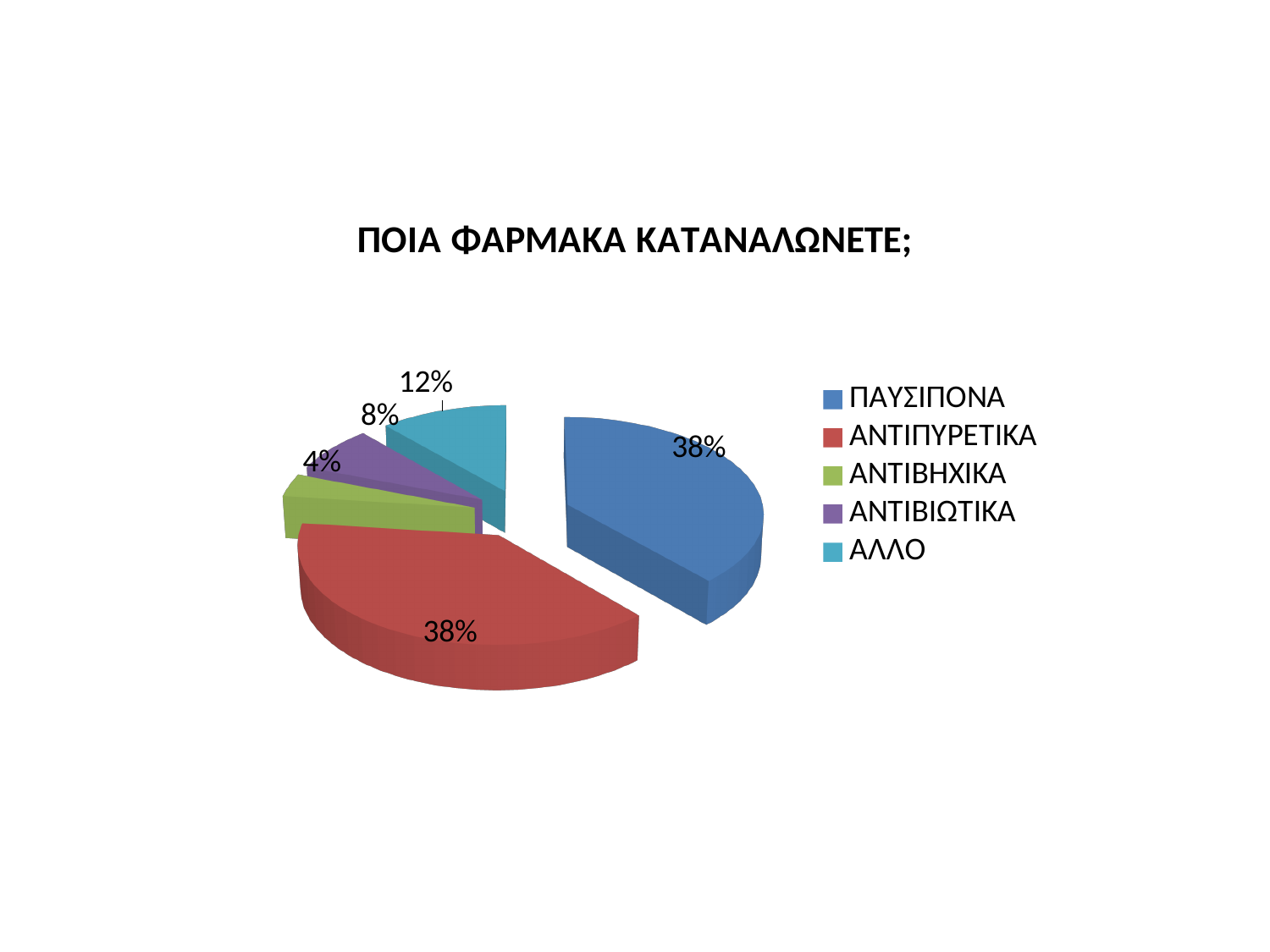
What is the difference in percentage points between the shares of ΠΑΥΣΙΠΟΝΑ and ΑΝΤΙΒΗΧΙΚΑ? 34 Which category has the smallest share of the pie? ΑΝΤΙΒΗΧΙΚΑ What is the difference in percentage points between the shares of ΑΛΛΟ and ΑΝΤΙΒΙΩΤΙΚΑ? 4 What share of the pie does ΑΛΛΟ represent? 12% What is the title of the chart? ΠΟΙΑ ΦΑΡΜΑΚΑ ΚΑΤΑΝΑΛΩΝΕΤΕ; What share of the pie does ΑΝΤΙΠΥΡΕΤΙΚΑ represent? 38% What share of the pie does ΑΝΤΙΒΙΩΤΙΚΑ represent? 8% How many categories does the pie chart show? 5 Which is larger, the share of ΑΛΛΟ or the share of ΑΝΤΙΒΙΩΤΙΚΑ? ΑΛΛΟ What kind of chart is shown on the slide? Pie chart